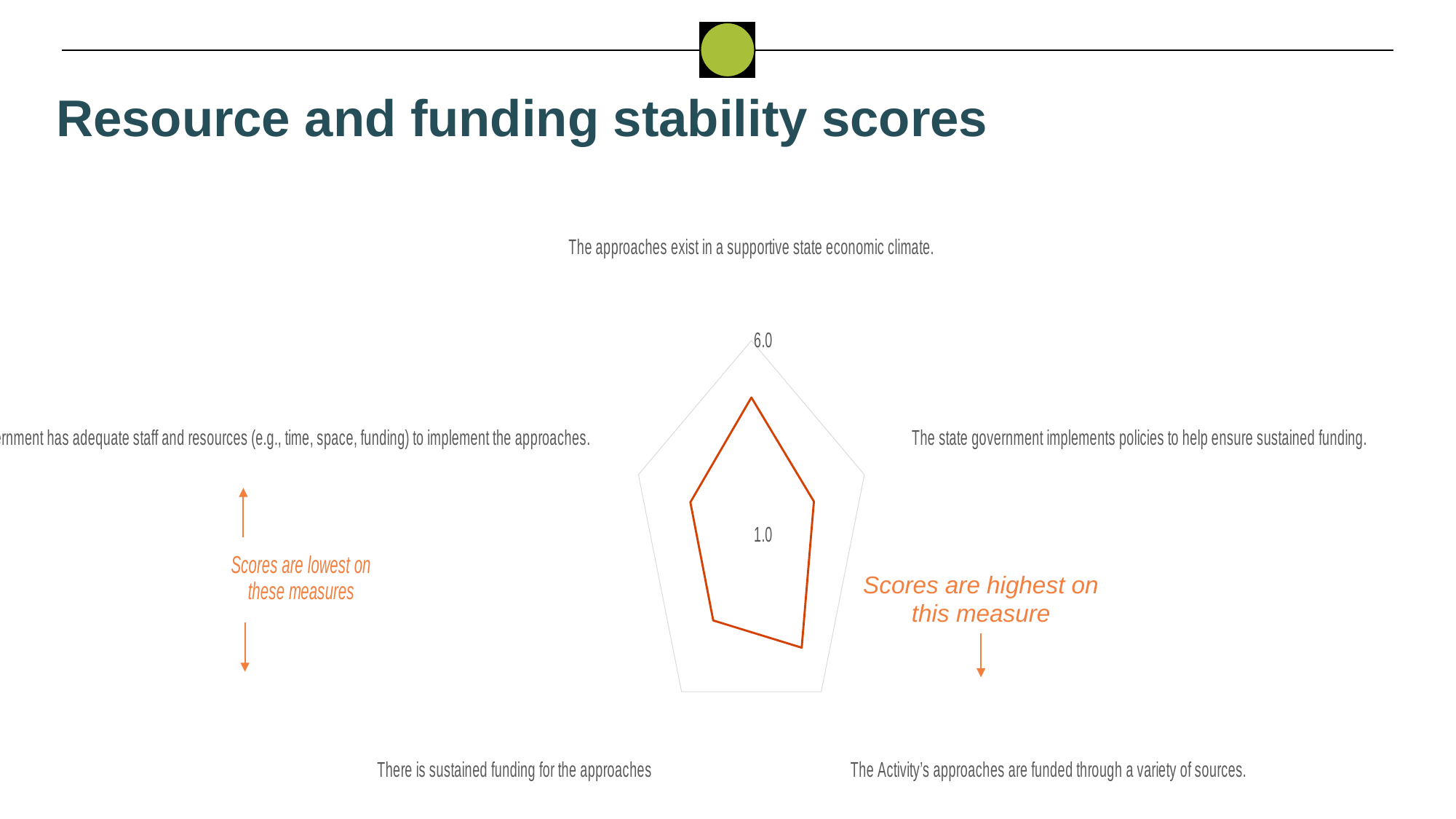
Is the score for 'The approaches exist in a supportive state economic climate' greater or less than 6.0? less What kind of chart is shown on the slide? Radar chart Which measure is the score for 'The approaches exist in a supportive state economic climate' larger than: that measure or 'The state government implements policies to help ensure sustained funding'? The approaches exist in a supportive state economic climate Is the score for 'There is sustained funding for the approaches' greater or less than 6.0? less What is the lowest value labelled on the radar chart's scale? 1.0 Is the score for 'The state government implements policies to help ensure sustained funding' greater or less than 1.0? greater What is the highest value labelled on the radar chart's scale? 6.0 What is the title of the slide containing the radar chart? Resource and funding stability scores How many data series are plotted on the radar chart? 1 How many measures (axes) does the radar chart have? 5